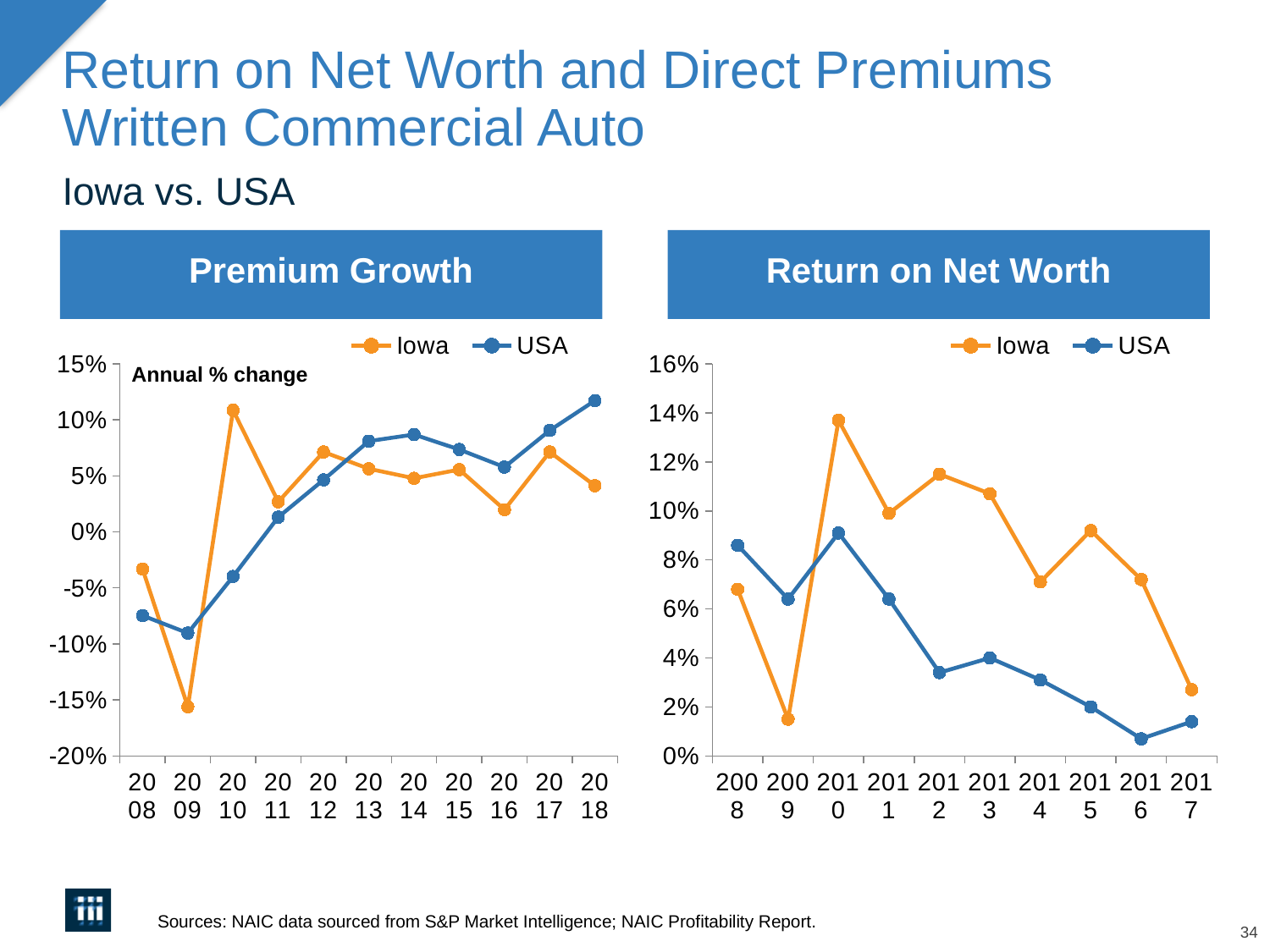
In the Return on Net Worth chart, does the USA series generally rise or fall from 2010 to 2016? fall In the Return on Net Worth chart, which year has the highest value for Iowa? 2010 In the Premium Growth chart, how many series does the legend list? 2 In the Premium Growth chart, what kind of chart is shown? line chart In the Return on Net Worth chart, is the Iowa value for 2012 greater or less than 10%? greater In the Return on Net Worth chart, which year has the lowest value for USA? 2016 In the Premium Growth chart, is the USA value for 2018 greater or less than 10%? greater In the Premium Growth chart, which year has the lowest value for Iowa? 2009 In the Premium Growth chart, is the Iowa value for 2009 greater or less than -10%? less In the Premium Growth chart, which series has the higher value in 2010, Iowa or USA? Iowa In the Premium Growth chart, how many years are plotted on the x axis? 11 In the Return on Net Worth chart, how many years are plotted on the x axis? 10